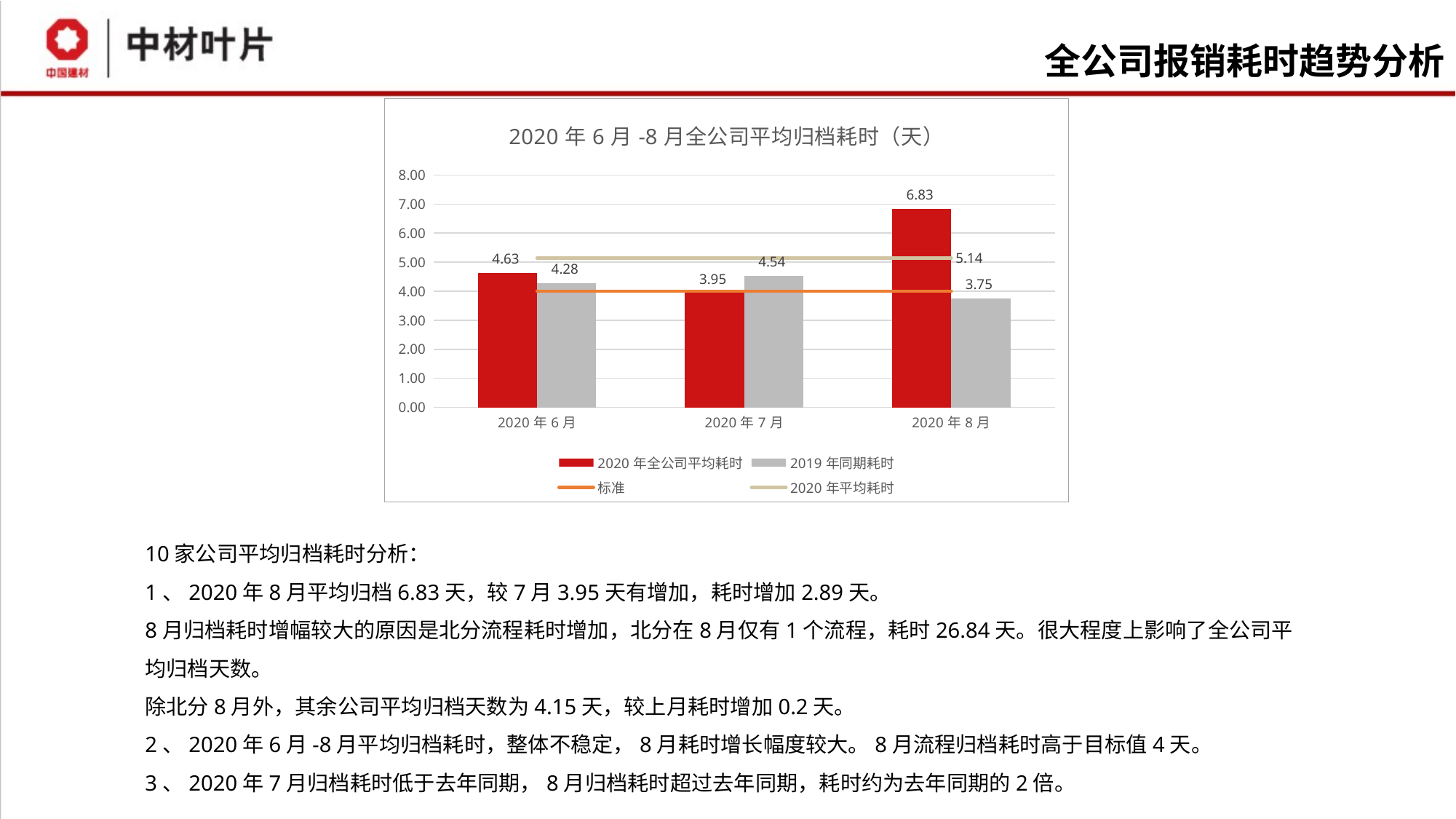
What kind of chart is this? Bar chart with lines Which month has the lowest value for 2019年同期耗时? 2020年8月 What is the value of 2019年同期耗时 for 2020年7月? 4.54 How many series does the legend list? 4 What is the difference between 2020年全公司平均耗时 and 2019年同期耗时 in 2020年8月? 3.08 What is the value of 2020年全公司平均耗时 for 2020年6月? 4.63 What value is labelled on the 2020年平均耗时 line? 5.14 What is the value of 2020年全公司平均耗时 for 2020年8月? 6.83 In 2020年7月, which is larger: 2020年全公司平均耗时 or 2019年同期耗时? 2019年同期耗时 Is the 标准 line greater or less than 5.00 on the axis? less Which month has the highest value for 2020年全公司平均耗时? 2020年8月 How many months are shown on the x axis? 3